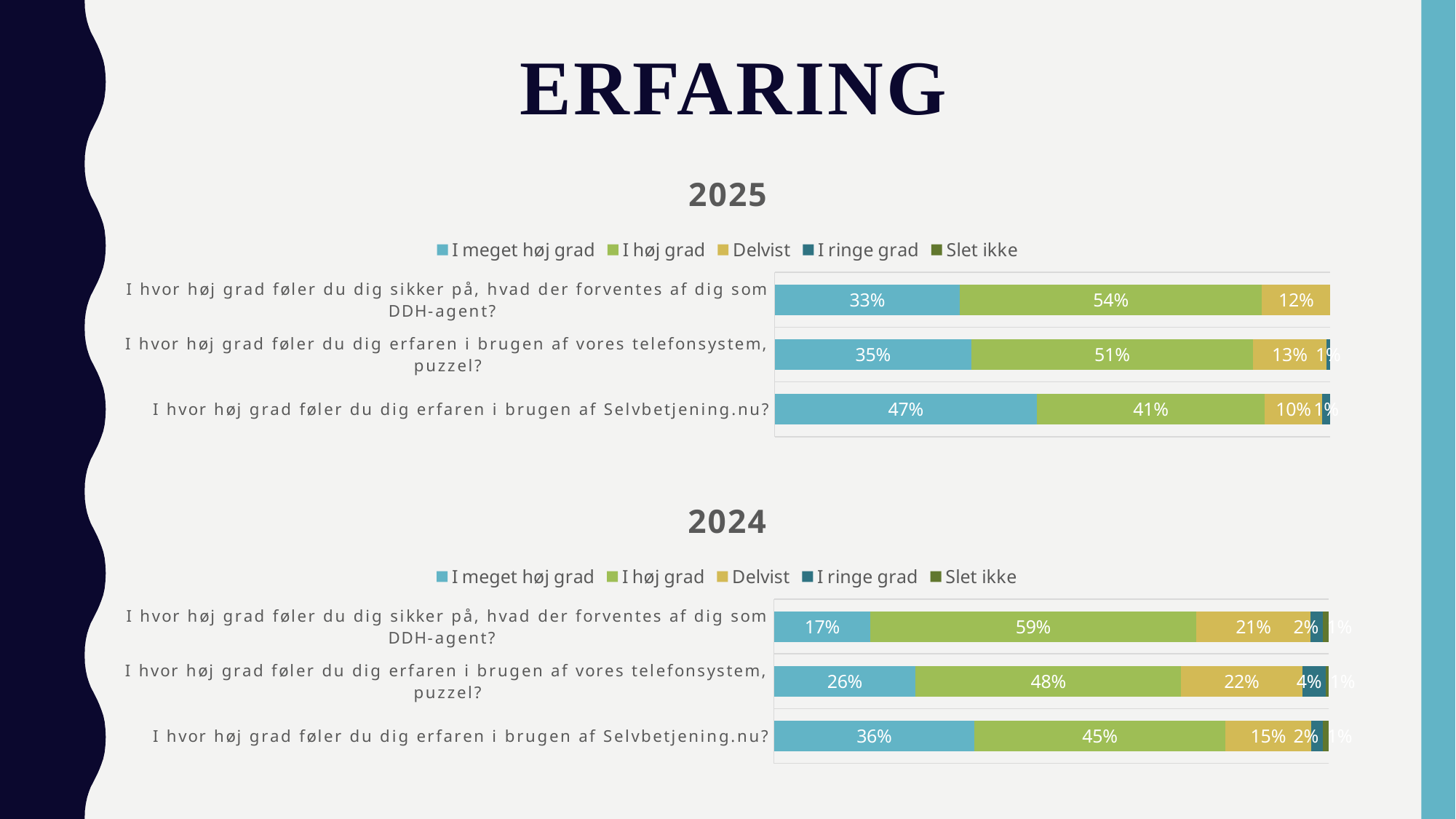
In the 2025 chart, what percentage answered 'I meget høj grad' to 'I hvor høj grad føler du dig erfaren i brugen af Selvbetjening.nu?' 47% In the 2024 chart, what percentage answered 'I ringe grad' to the question about the telephone system puzzel? 4% How many series does the legend of the 2025 chart list? 5 In the 2024 chart, which question has the lowest share of 'I meget høj grad' answers? I hvor høj grad føler du dig sikker på, hvad der forventes af dig som DDH-agent? What type of chart is the 2025 chart? Stacked bar chart In the 2024 chart, what percentage answered 'Delvist' to the question about the telephone system puzzel? 22% In the 2024 chart, what percentage answered 'I høj grad' to 'I hvor høj grad føler du dig sikker på, hvad der forventes af dig som DDH-agent?' 59% What is the difference between the 'I meget høj grad' share for the DDH-agent question in 2025 and in 2024? 16 percentage points Which legend entry is shown in light blue in both charts? I meget høj grad In the 2025 chart, is the 'I høj grad' share larger for the DDH-agent question or for the Selvbetjening.nu question? DDH-agent question In the 2025 chart, which question has the highest share of 'I meget høj grad' answers? I hvor høj grad føler du dig erfaren i brugen af Selvbetjening.nu? How many questions (categories) are shown in the 2024 chart? 3